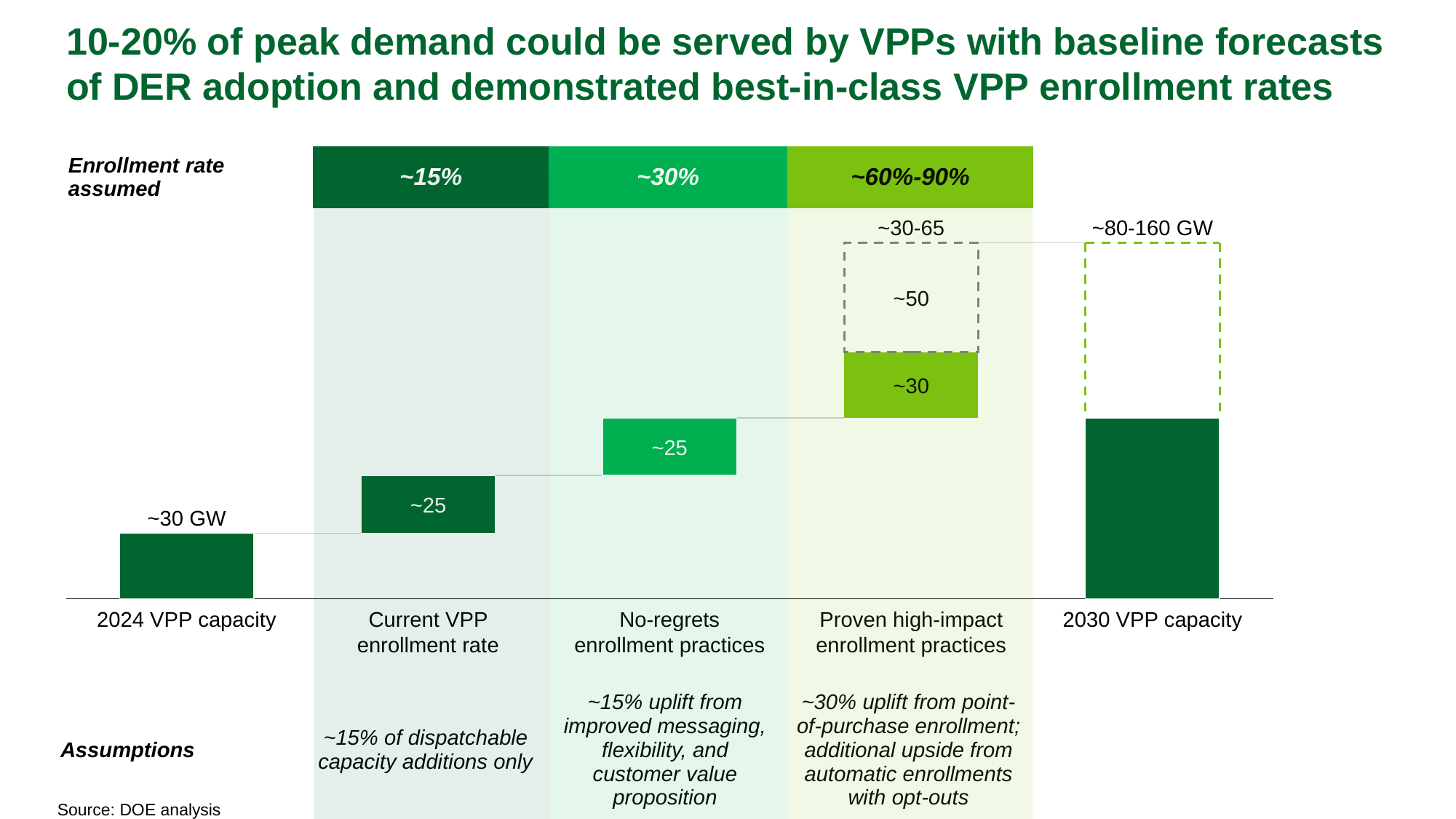
What kind of chart is shown on the slide? Waterfall bar chart What value is printed on the solid green portion of the Proven high-impact enrollment practices bar? ~30 What value is printed on the No-regrets enrollment practices bar? ~25 What value is printed on the Current VPP enrollment rate bar? ~25 How many categories are shown along the x axis of the chart? 5 What enrollment rate is assumed for the No-regrets enrollment practices step? ~30% Which bar is taller, 2024 VPP capacity or 2030 VPP capacity? 2030 VPP capacity What range label is printed above the Proven high-impact enrollment practices bar? ~30-65 What value is printed inside the dashed portion of the Proven high-impact enrollment practices bar? ~50 What value label is printed above the 2024 VPP capacity bar? ~30 GW What value label is printed above the 2030 VPP capacity bar? ~80-160 GW What enrollment rate is assumed for the Proven high-impact enrollment practices step? ~60%-90%